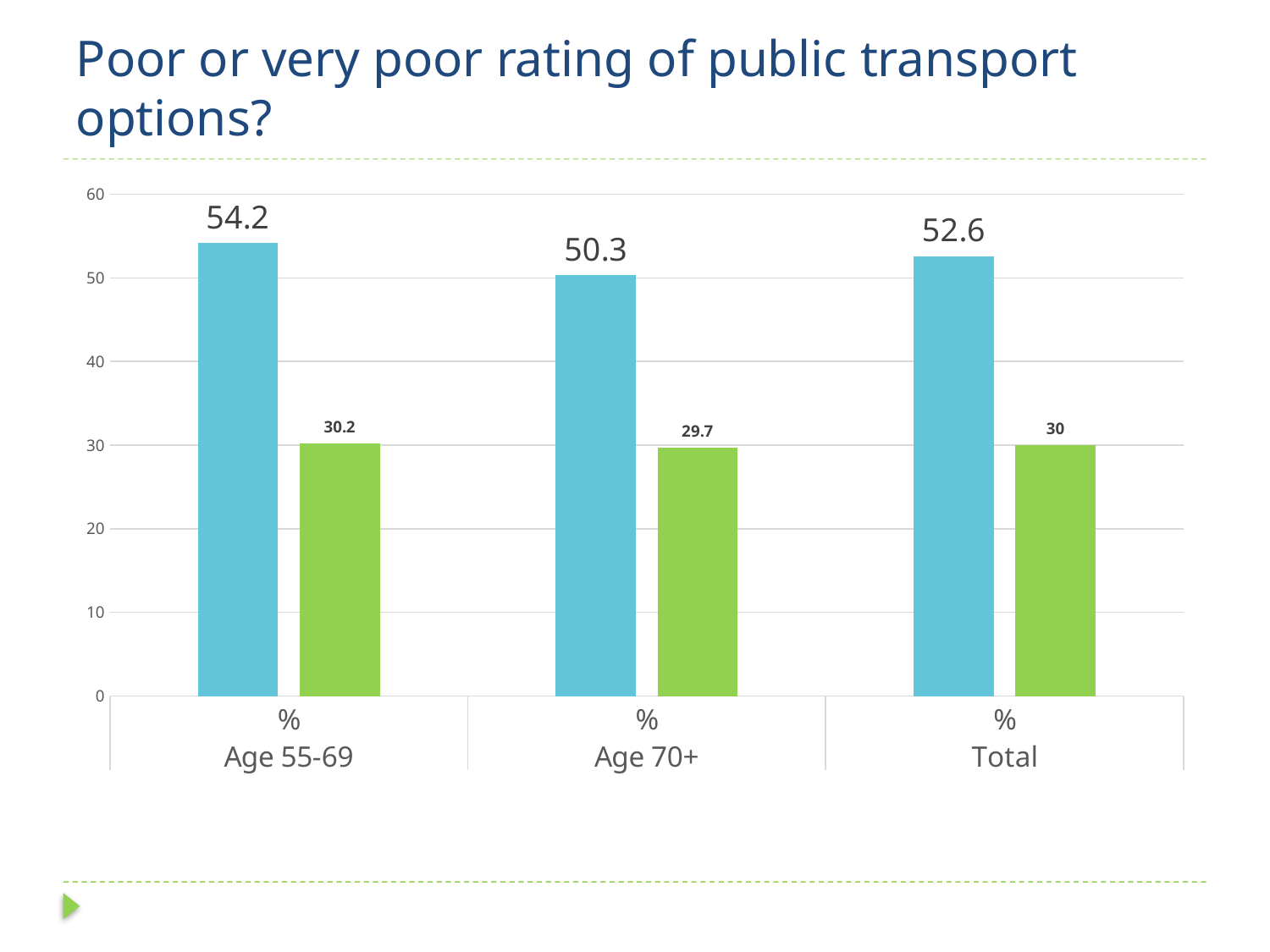
What is the value of the blue bar for Total? 52.6 What is the difference between the blue bar and the green bar for Age 55-69? 24 Which category has the lowest green bar? Age 70+ What is the difference between the blue bars for Age 55-69 and Age 70+? 3.9 What is the value of the blue bar for Age 55-69? 54.2 What is the value of the green bar for Total? 30 What is the title of the slide containing the chart? Poor or very poor rating of public transport options? What kind of chart is shown on the slide? Bar chart What is the value of the green bar for Age 70+? 29.7 Which category has the highest blue bar? Age 55-69 How many categories are shown on the x axis? 3 Which is larger: the blue bar for Age 70+ or the blue bar for Total? Total